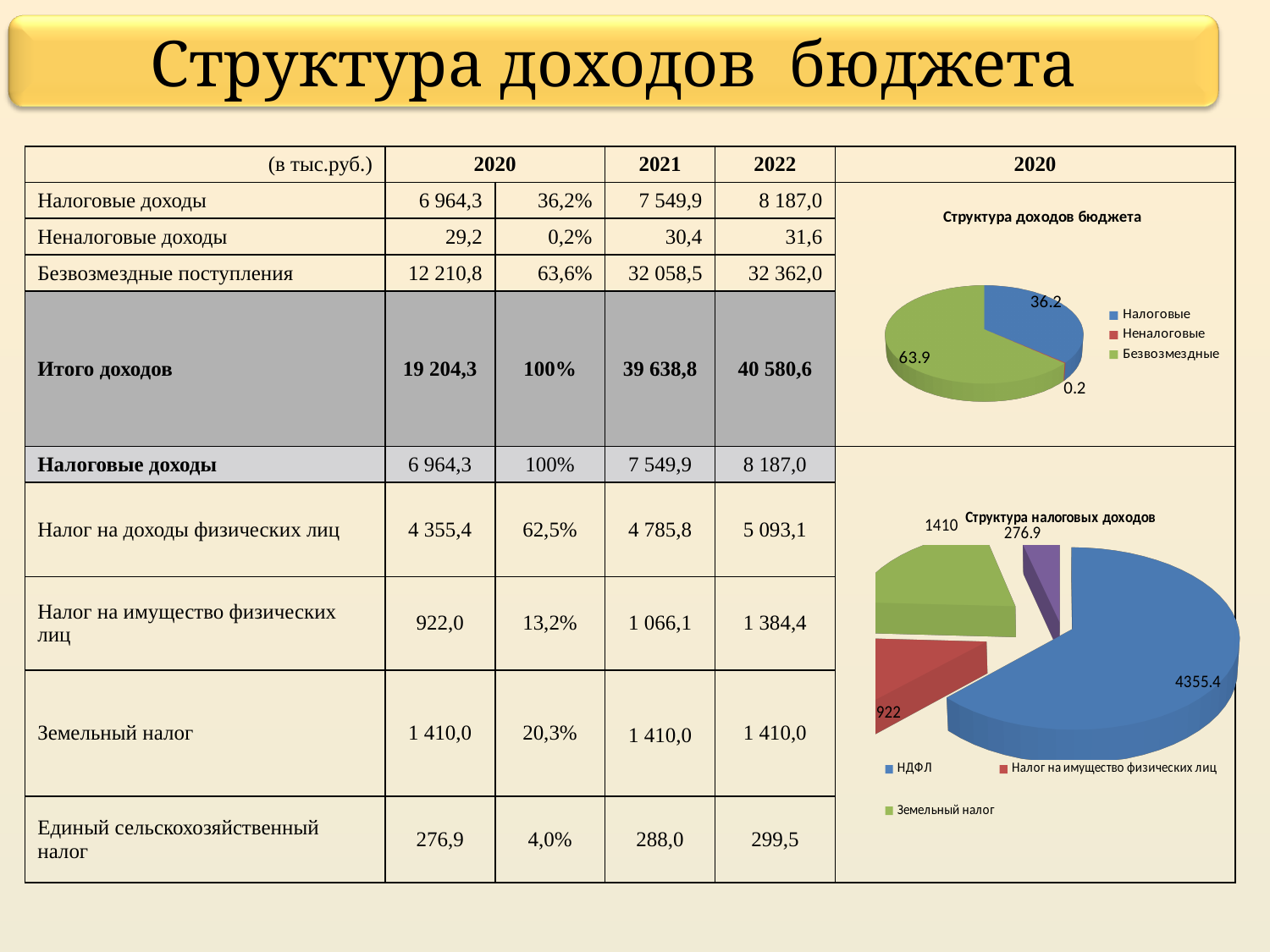
In the top chart "Структура доходов бюджета", which category has the largest slice? Безвозмездные In the top chart "Структура доходов бюджета", what value is shown for Неналоговые? 0.2 In the bottom chart "Структура налоговых доходов", what value is shown for Налог на имущество физических лиц? 922 In the bottom chart "Структура налоговых доходов", what value is shown for Земельный налог? 1410 In the top chart "Структура доходов бюджета", which category has the smallest slice? Неналоговые In the top chart "Структура доходов бюджета", what value is shown for Безвозмездные? 63.9 In the bottom chart "Структура налоговых доходов", what value is shown for НДФЛ? 4355.4 What kind of chart is the top chart titled "Структура доходов бюджета"? pie chart In the bottom chart "Структура налоговых доходов", which category has the largest slice? НДФЛ How many entries does the legend of the top chart "Структура доходов бюджета" list? 3 In the top chart "Структура доходов бюджета", what value is shown for Налоговые? 36.2 In the bottom chart "Структура налоговых доходов", what is the difference between the values for Земельный налог and Налог на имущество физических лиц? 488